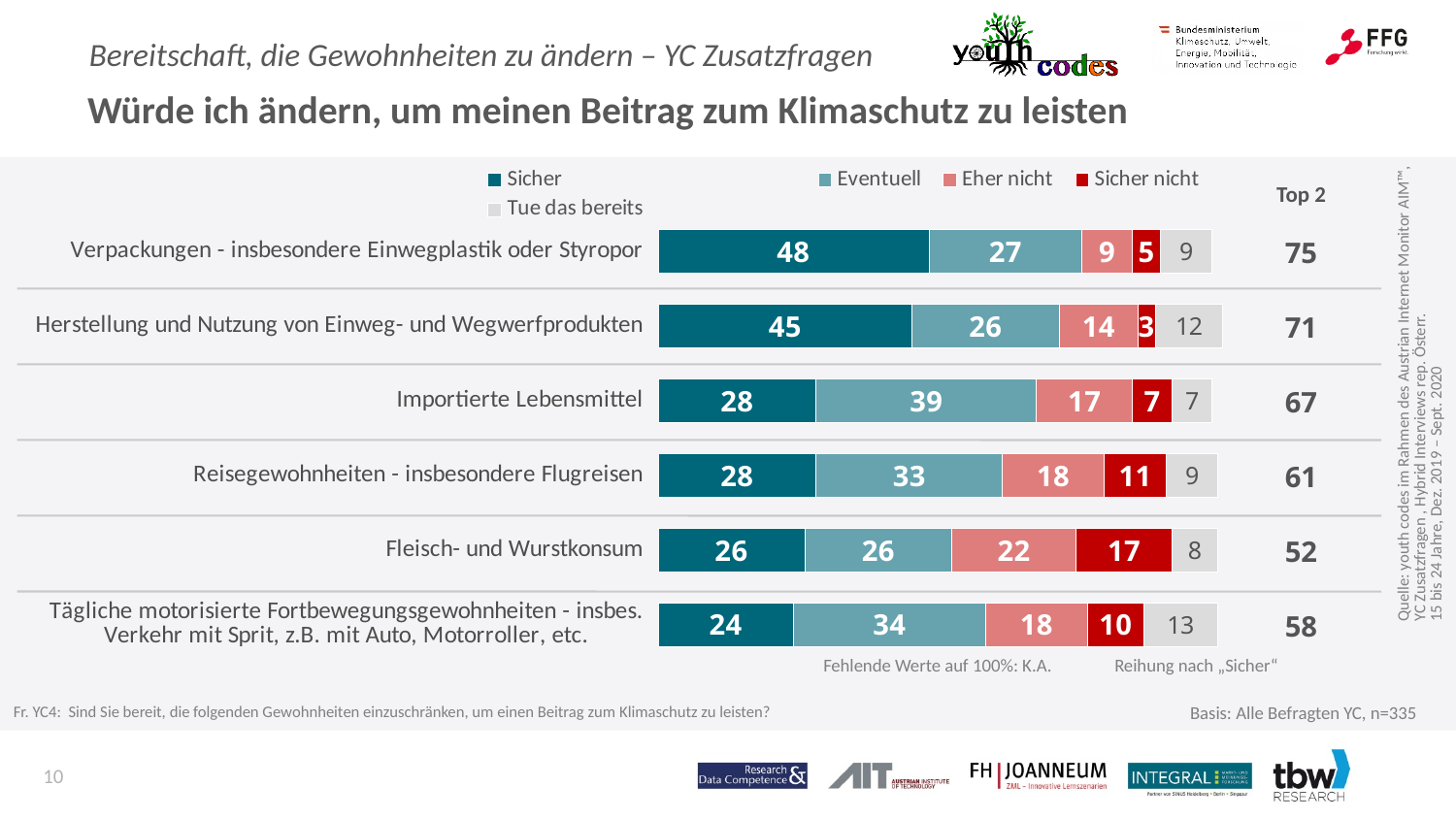
How many series does the legend list? 5 Which category has the lowest Top 2 value? Fleisch- und Wurstkonsum How many categories (habits) are shown in the chart? 6 What is the total of all segments in the bar for "Herstellung und Nutzung von Einweg- und Wegwerfprodukten"? 100 Which is larger: the "Eher nicht" value for "Reisegewohnheiten - insbesondere Flugreisen" or for "Fleisch- und Wurstkonsum"? Fleisch- und Wurstkonsum What type of chart is shown on the slide? Stacked bar chart What is the "Sicher" value for "Verpackungen - insbesondere Einwegplastik oder Styropor"? 48 What is the "Sicher nicht" value for "Fleisch- und Wurstkonsum"? 17 What is the difference between the "Sicher" values for "Verpackungen - insbesondere Einwegplastik oder Styropor" and "Herstellung und Nutzung von Einweg- und Wegwerfprodukten"? 3 What is the "Eventuell" value for "Importierte Lebensmittel"? 39 What is the "Tue das bereits" value for "Tägliche motorisierte Fortbewegungsgewohnheiten"? 13 Which category has the highest "Sicher" value? Verpackungen - insbesondere Einwegplastik oder Styropor